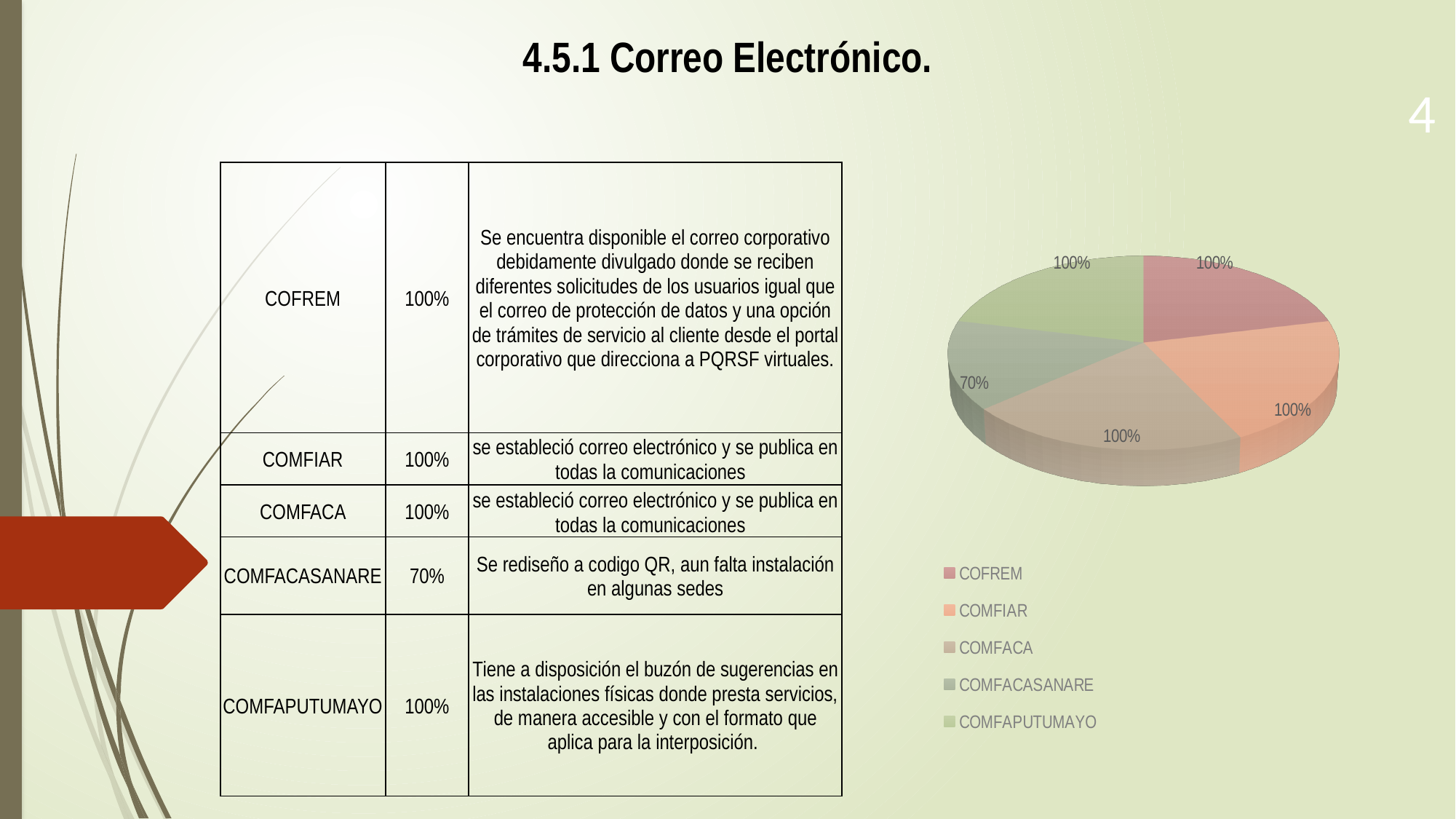
Which has the larger value in the pie chart, COMFIAR or COMFACASANARE? COMFIAR Which legend entry is listed first in the pie chart's legend? COFREM What kind of chart is shown on the slide? pie chart What value is labelled for COMFIAR in the pie chart? 100% What is the difference between the values for COMFACA and COMFACASANARE in the pie chart? 30% What value is labelled for COFREM in the pie chart? 100% Which category has the lowest value in the pie chart? COMFACASANARE What value is labelled for COMFACASANARE in the pie chart? 70% How many entries does the legend of the pie chart list? 5 Which legend entry is listed last in the pie chart's legend? COMFAPUTUMAYO How many slices does the pie chart have? 5 What value is labelled for COMFAPUTUMAYO in the pie chart? 100%